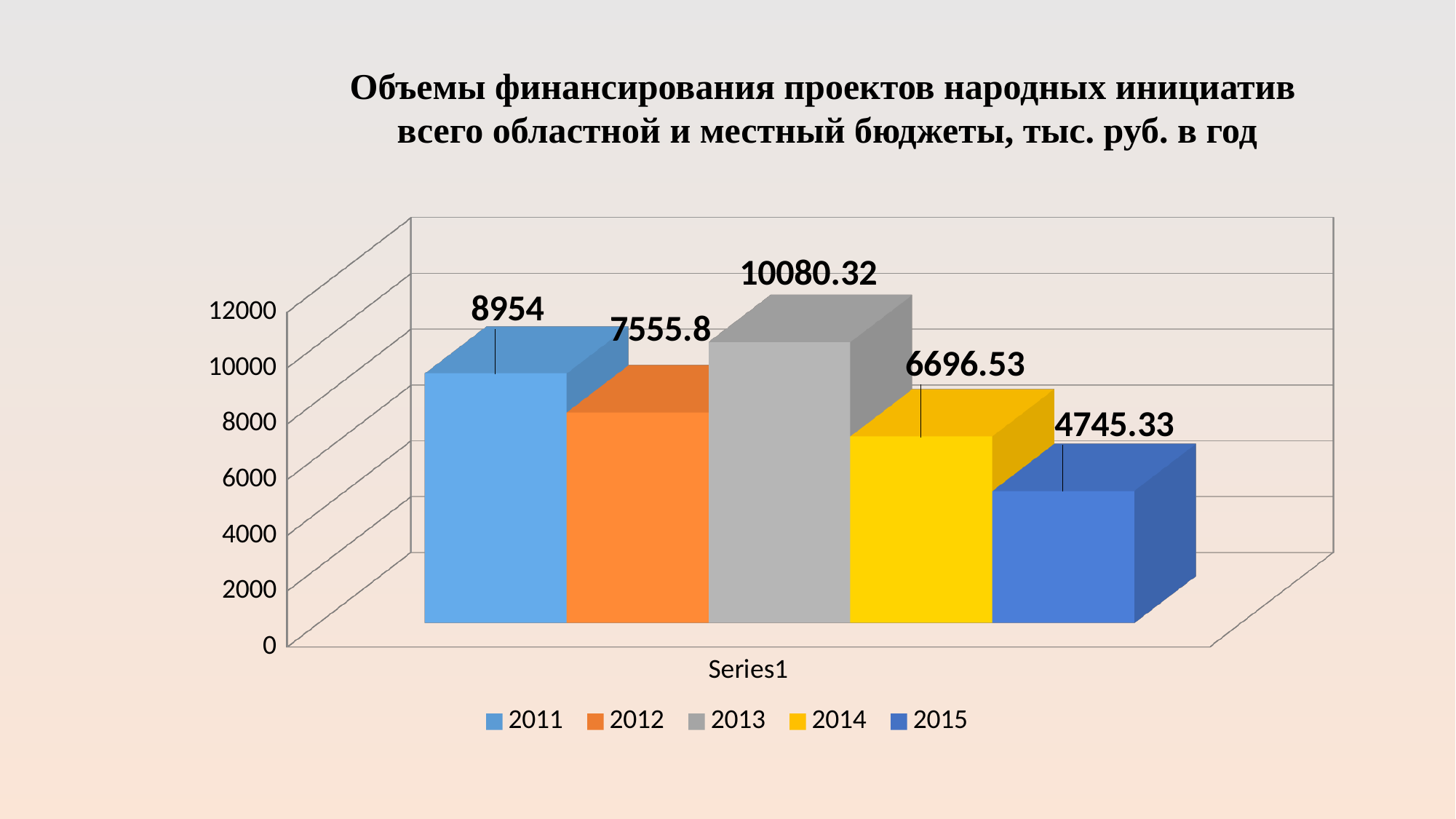
Which year has the highest value? 2013 What is the value for 2015? 4745.33 Which is larger, the value for 2012 or the value for 2014? 2012 What kind of chart is shown on the slide? bar chart Which year has the lowest value? 2015 What is the value for 2013? 10080.32 What is the value for 2011? 8954 What is the value for 2014? 6696.53 How many entries does the legend list? 5 How many bars are plotted on the chart? 5 What is the difference between the values for 2013 and 2011? 1126.32 What is the difference between the values for 2014 and 2015? 1951.2